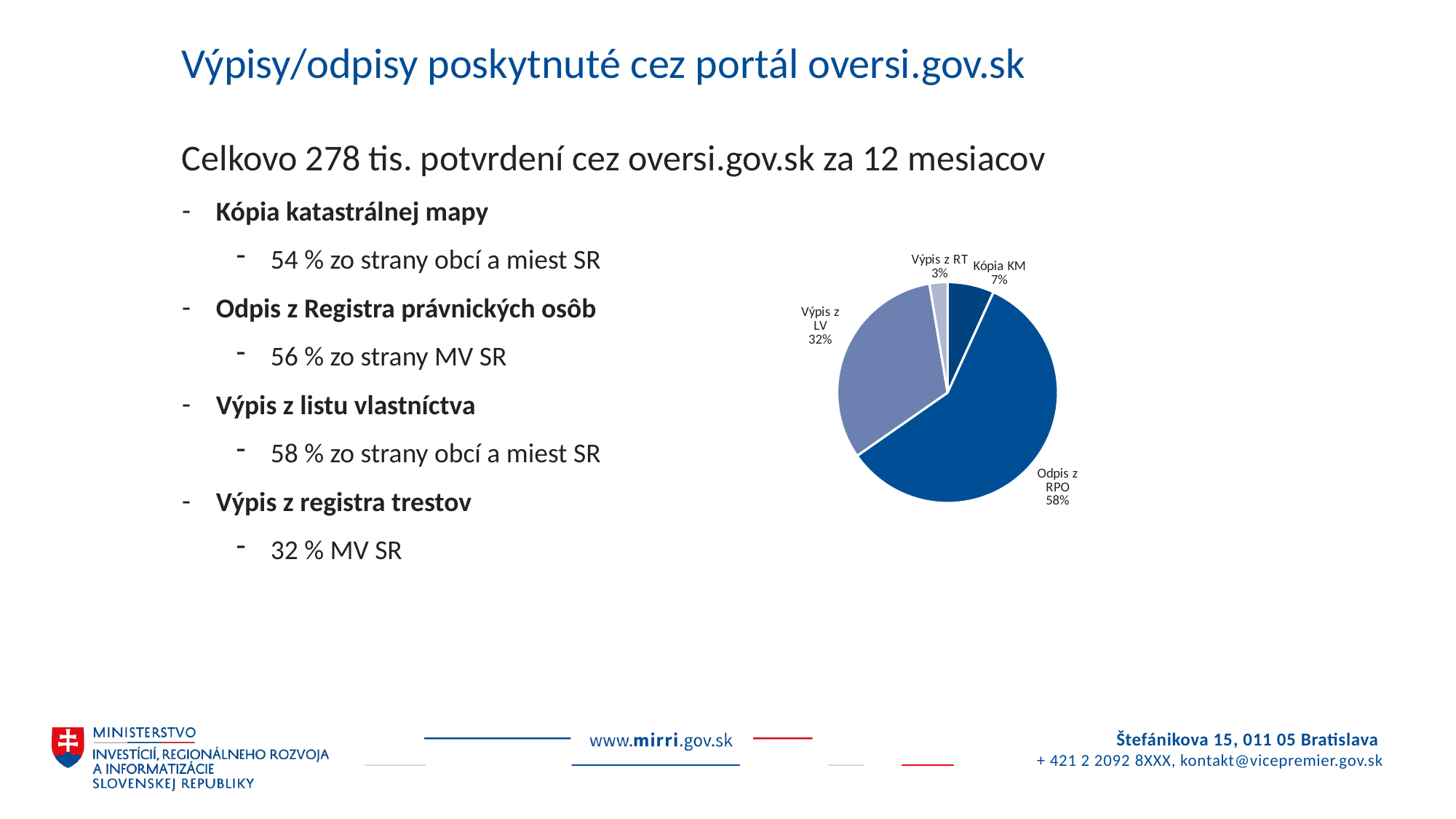
Which slice of the pie chart is the largest? Odpis z RPO Which slice of the pie chart is the smallest? Výpis z RT How many slices does the pie chart have? 4 Is the share for Výpis z LV greater or less than 50%? less What share of the pie does Výpis z RT represent? 3% What share of the pie does Kópia KM represent? 7% What is the difference in percentage points between Odpis z RPO and Výpis z LV? 26 What is the combined share of Kópia KM and Výpis z RT? 10% What type of chart is shown on the slide? pie chart What share of the pie does Odpis z RPO represent? 58% Which is larger, the share for Kópia KM or the share for Výpis z RT? Kópia KM